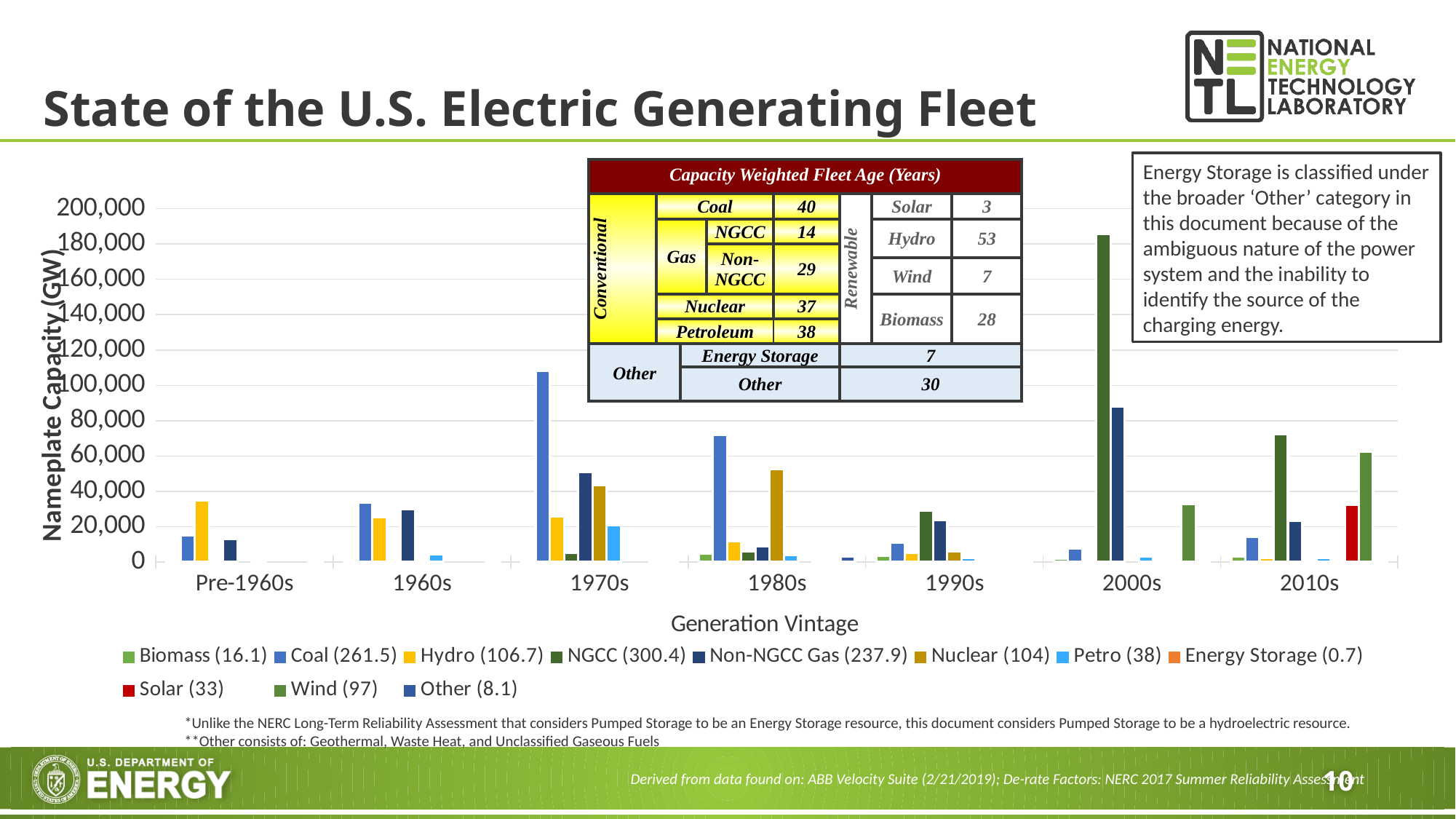
Is the value for NGCC in the 2000s greater or less than 160,000? greater How many generation vintage categories are shown on the x axis? 7 Is the value for Nuclear in the 1980s greater or less than 40,000? greater What is the title of the x axis? Generation Vintage Which generation vintage contains the tallest bar in the chart? 2000s Is the value for Coal in the 1970s greater or less than 100,000? greater How many series does the chart legend list? 11 Which is larger, the Coal bar for the 1970s or the Coal bar for the 1980s? Coal in the 1970s What is the title of the y axis? Nameplate Capacity (GW) What kind of chart is shown on the slide? bar chart Which series has the highest bar in the 1970s vintage? Coal